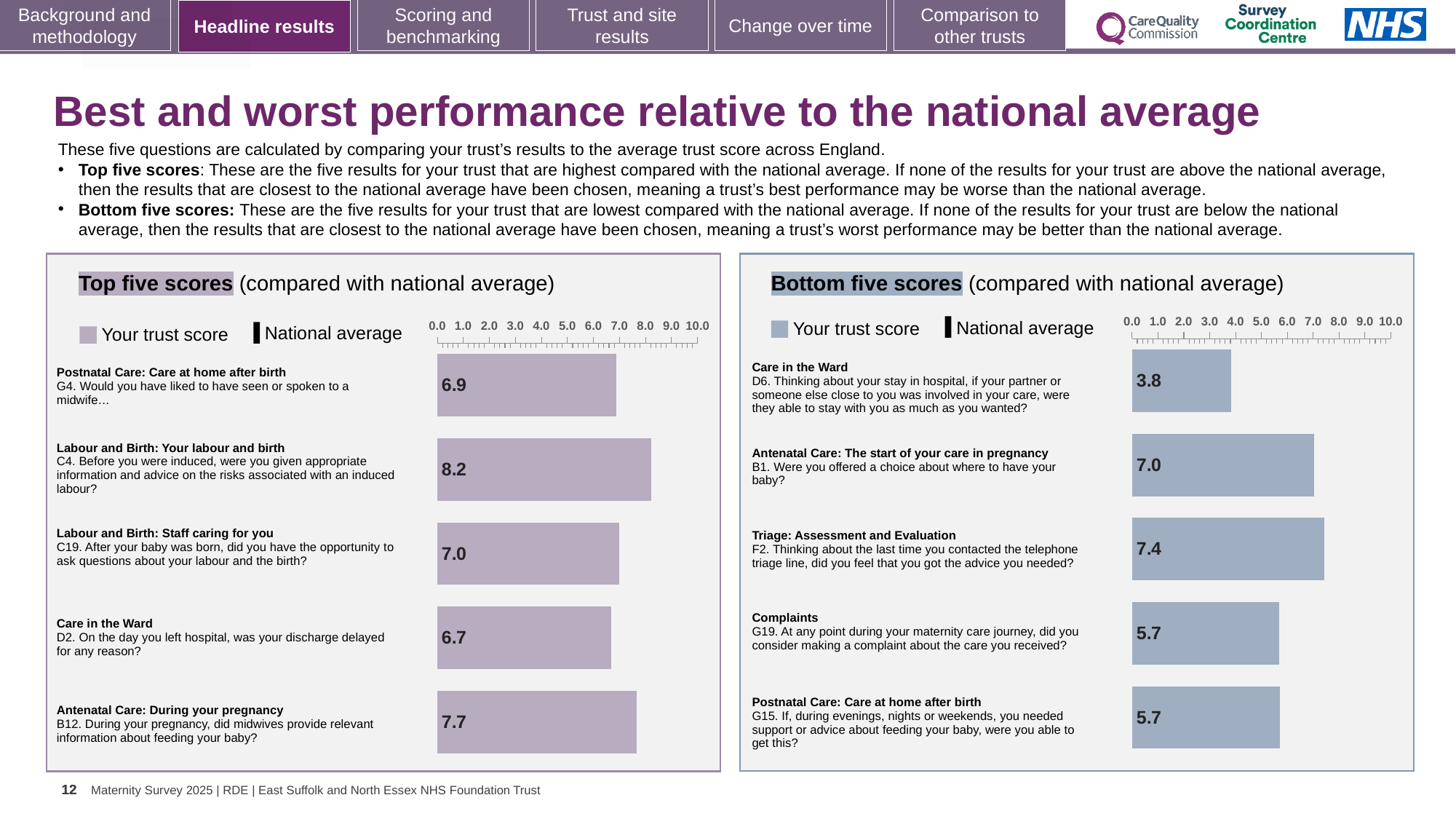
What type of chart is the Bottom five scores chart? Bar chart In the Bottom five scores chart, what is the trust score for D6 (Care in the Ward)? 3.8 What two entries does the legend of the Top five scores chart list? Your trust score and National average In the Top five scores chart, what is the difference between the trust scores for C4 and D2? 1.5 In the Bottom five scores chart, is the trust score for G19 (Complaints) greater or less than 6.0? less In the Bottom five scores chart, which has the larger trust score: F2 or B1? F2 In the Bottom five scores chart, which question has the highest trust score? F2 (Triage: Assessment and Evaluation) In the Top five scores chart, which question has the highest trust score? C4 (Labour and Birth: Your labour and birth) In the Top five scores chart, what is the trust score for B12 (Antenatal Care: During your pregnancy)? 7.7 In the Top five scores chart, what is the trust score for C4 (Before you were induced, were you given appropriate information and advice on the risks associated with an induced labour?)? 8.2 In the Bottom five scores chart, which question has the lowest trust score? D6 (Care in the Ward) How many bars are shown in the Top five scores chart? 5